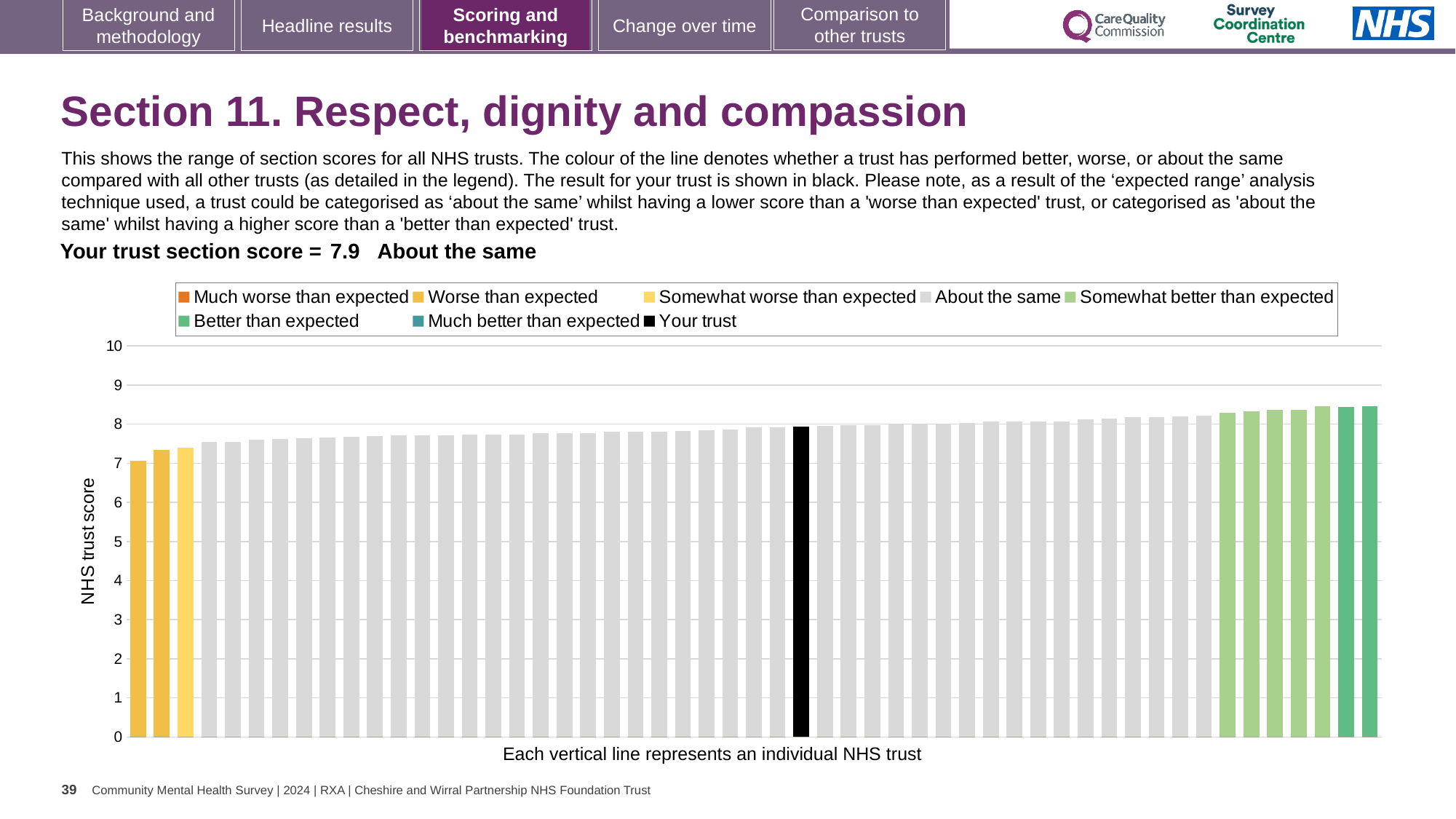
What colour is the bar representing your trust? black Is the value of the rightmost (highest) bar greater or less than 8? greater How many entries does the chart legend list? 8 Is the value of the leftmost (lowest) bar greater or less than 8? less Do the bar values rise or fall from left to right along the x axis? rise How many bars are coloured as 'Somewhat better than expected' (light green)? 5 What is the label on the vertical axis of the chart? NHS trust score How many bars are coloured as 'Worse than expected'? 2 What is the section score for your trust shown on the slide? 7.9 Is the value of the leftmost bar greater or less than 6? greater How many bars are coloured as 'Better than expected' (dark green)? 2 What kind of chart is shown on the slide? bar chart